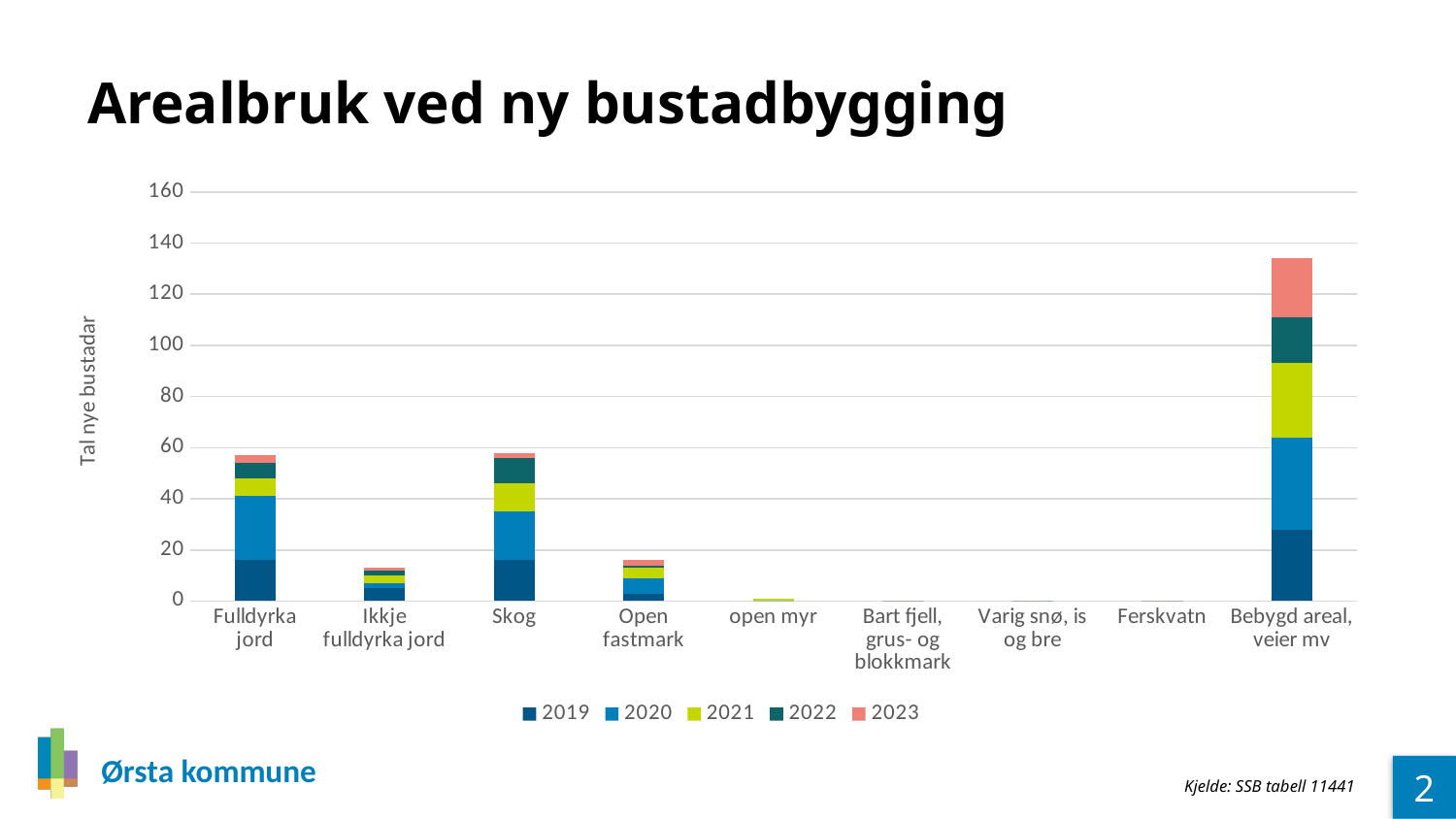
How many series does the legend list? 5 What is the label on the vertical axis? Tal nye bustadar What is the title of the chart? Arealbruk ved ny bustadbygging Is the total value for Fulldyrka jord greater or less than 40? greater Which category has the highest total number of new dwellings? Bebygd areal, veier mv How many categories are shown on the x axis? 9 Is the total value for Ikkje fulldyrka jord greater or less than 20? less Is the total value for Bebygd areal, veier mv greater or less than 120? greater What kind of chart is shown on the slide? Stacked bar chart Which has a larger total, Fulldyrka jord or Ikkje fulldyrka jord? Fulldyrka jord